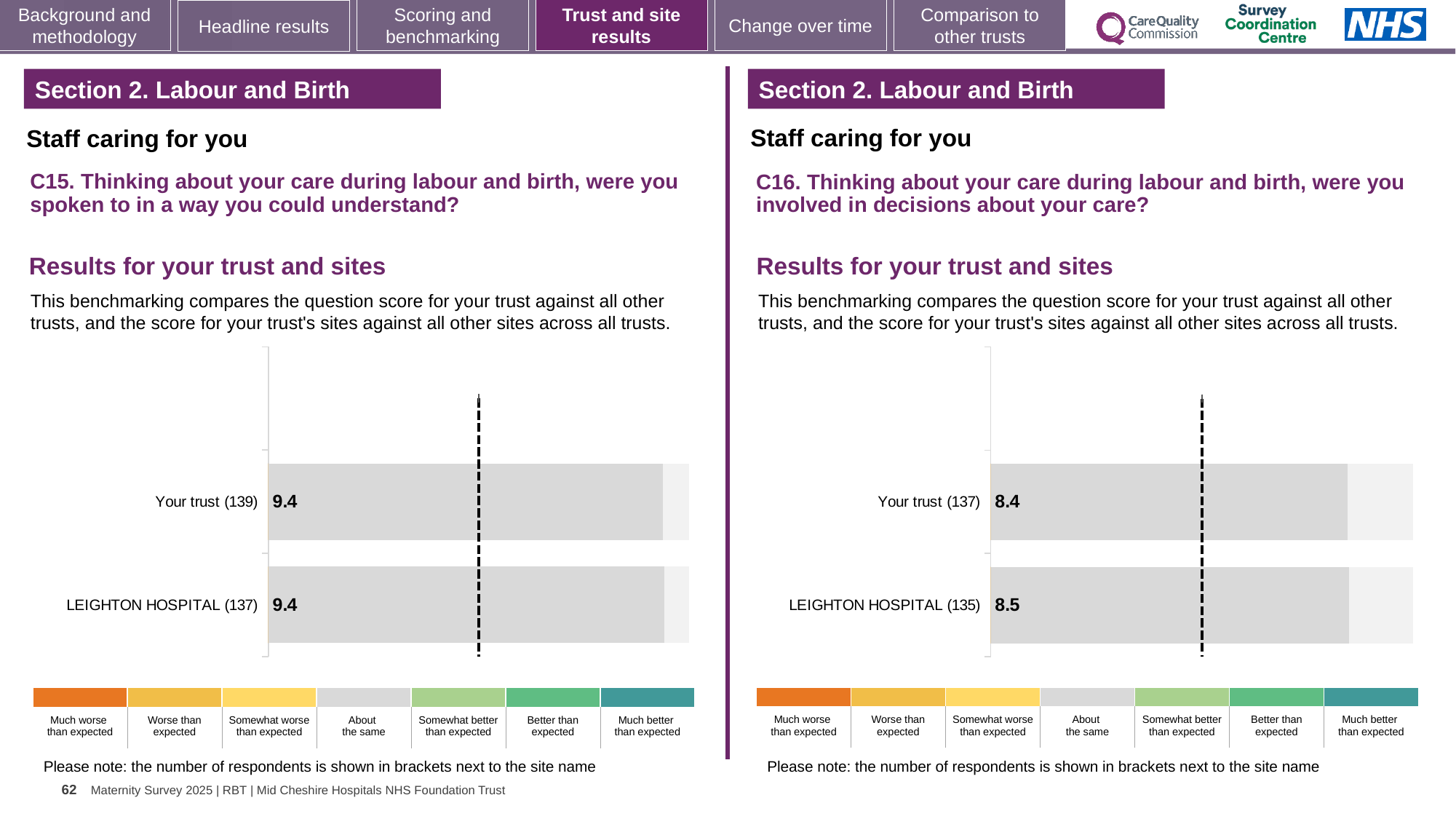
On the left chart (C15), how many respondents are shown in brackets for Your trust? 139 On the left chart (C15), what is the score for LEIGHTON HOSPITAL? 9.4 On the right chart (C16), what is the score for LEIGHTON HOSPITAL? 8.5 On the left chart (C15), what is the difference between the Your trust score and the LEIGHTON HOSPITAL score? 0 On the right chart (C16), how many respondents are shown in brackets for LEIGHTON HOSPITAL? 135 On the left chart (C15), what is the score for Your trust? 9.4 On the right chart (C16), what is the score for Your trust? 8.4 How many bars are plotted on the left chart (C15)? 2 On the right chart (C16), what is the difference between the LEIGHTON HOSPITAL score and the Your trust score? 0.1 What kind of chart is used on the right (C16)? Bar chart On the right chart (C16), which has the higher score, Your trust or LEIGHTON HOSPITAL? LEIGHTON HOSPITAL